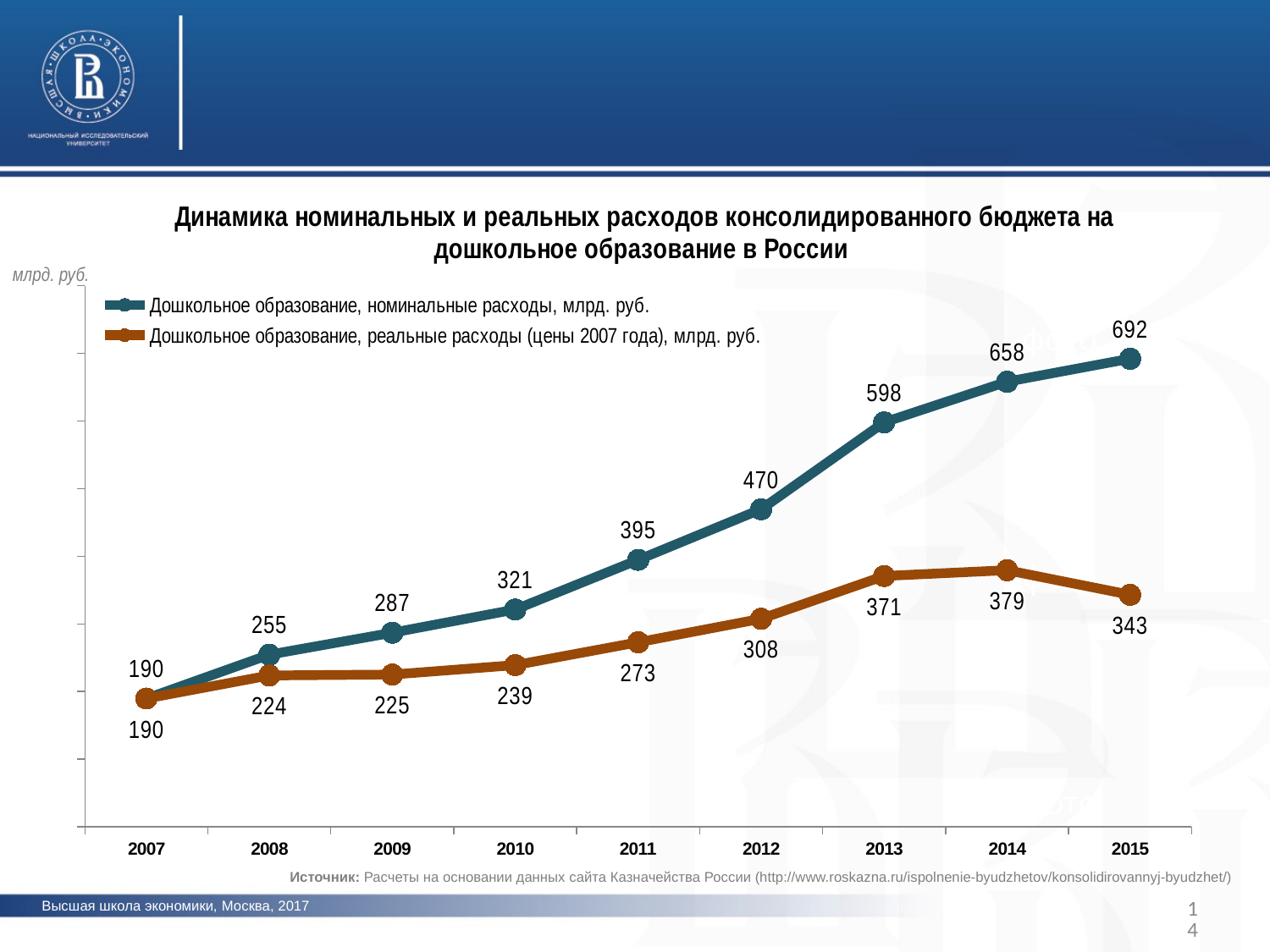
What type of chart is shown on the slide? line chart Which is larger in 2012: nominal expenditures (470) or real expenditures (308) on preschool education? nominal expenditures In which year are nominal expenditures on preschool education highest? 2015 What is the difference between nominal and real expenditures on preschool education in 2015? 349 What is the value of nominal expenditures on preschool education (Дошкольное образование, номинальные расходы) in 2013? 598 How many series does the legend list? 2 Do nominal expenditures on preschool education rise or fall from 2007 to 2015? rise How many years are plotted along the x axis? 9 In which year are real expenditures on preschool education (цены 2007 года) highest? 2014 By how much did real expenditures on preschool education change from 2014 to 2015? fell by 36 What unit is shown in the top-left corner of the chart? млрд. руб. What is the value of real expenditures on preschool education (цены 2007 года) in 2011? 273